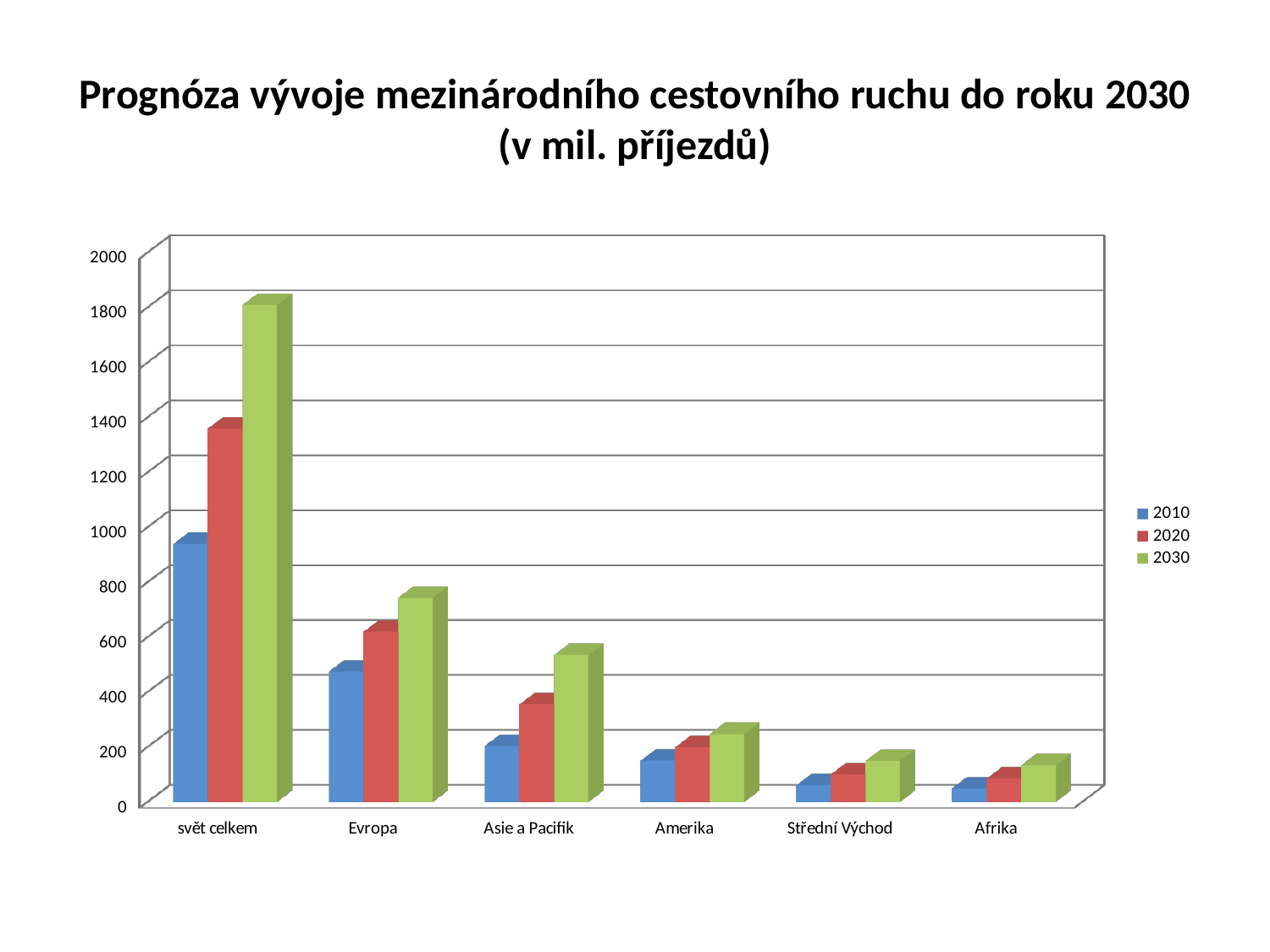
Which category has the highest value for 2030? svět celkem Do the values for Evropa rise or fall from 2010 to 2030? rise Is the value for svět celkem in 2030 greater or less than 1600? greater What kind of chart is shown on the slide? bar chart How many categories are shown on the x axis? 6 Which is larger for 2020: Amerika or Asie a Pacifik? Asie a Pacifik How many series does the legend list? 3 Which is larger for 2030: Evropa or Asie a Pacifik? Evropa Is the value for Evropa in 2030 greater or less than 600? greater Is the value for Amerika in 2030 greater or less than 400? less